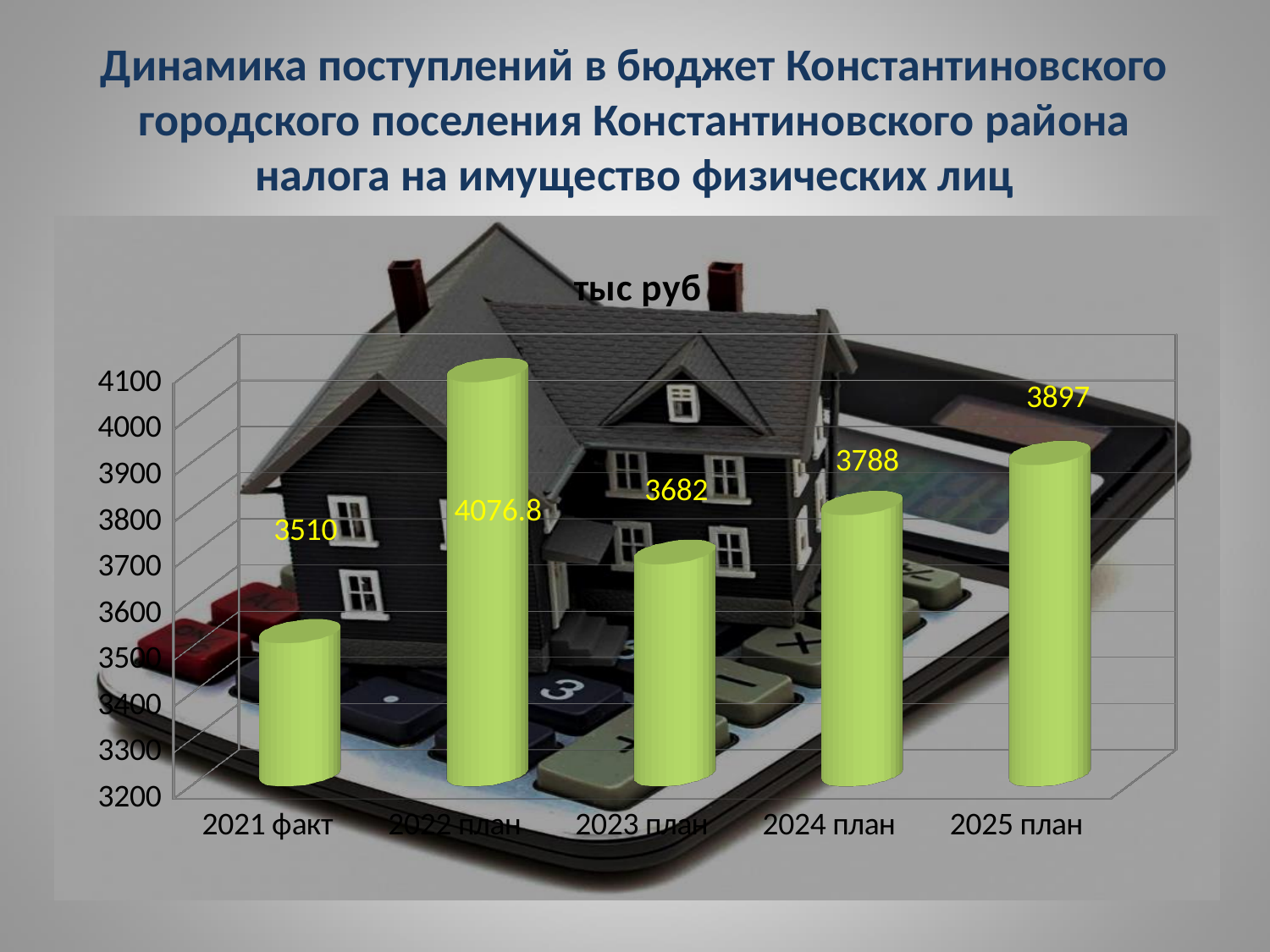
What is the title shown above the chart? тыс руб What is the value for 2023 план? 3682 What is the value for 2025 план? 3897 What is the difference between the values for 2025 план and 2024 план? 109 What kind of chart is shown on the slide? bar chart What is the value for 2021 факт? 3510 Which is larger, the value for 2023 план or the value for 2024 план? 2024 план How many categories are shown on the x axis? 5 What is the value for 2022 план? 4076.8 Is the value for 2024 план greater or less than 3700? greater Which category has the lowest value? 2021 факт Which category has the highest value? 2022 план